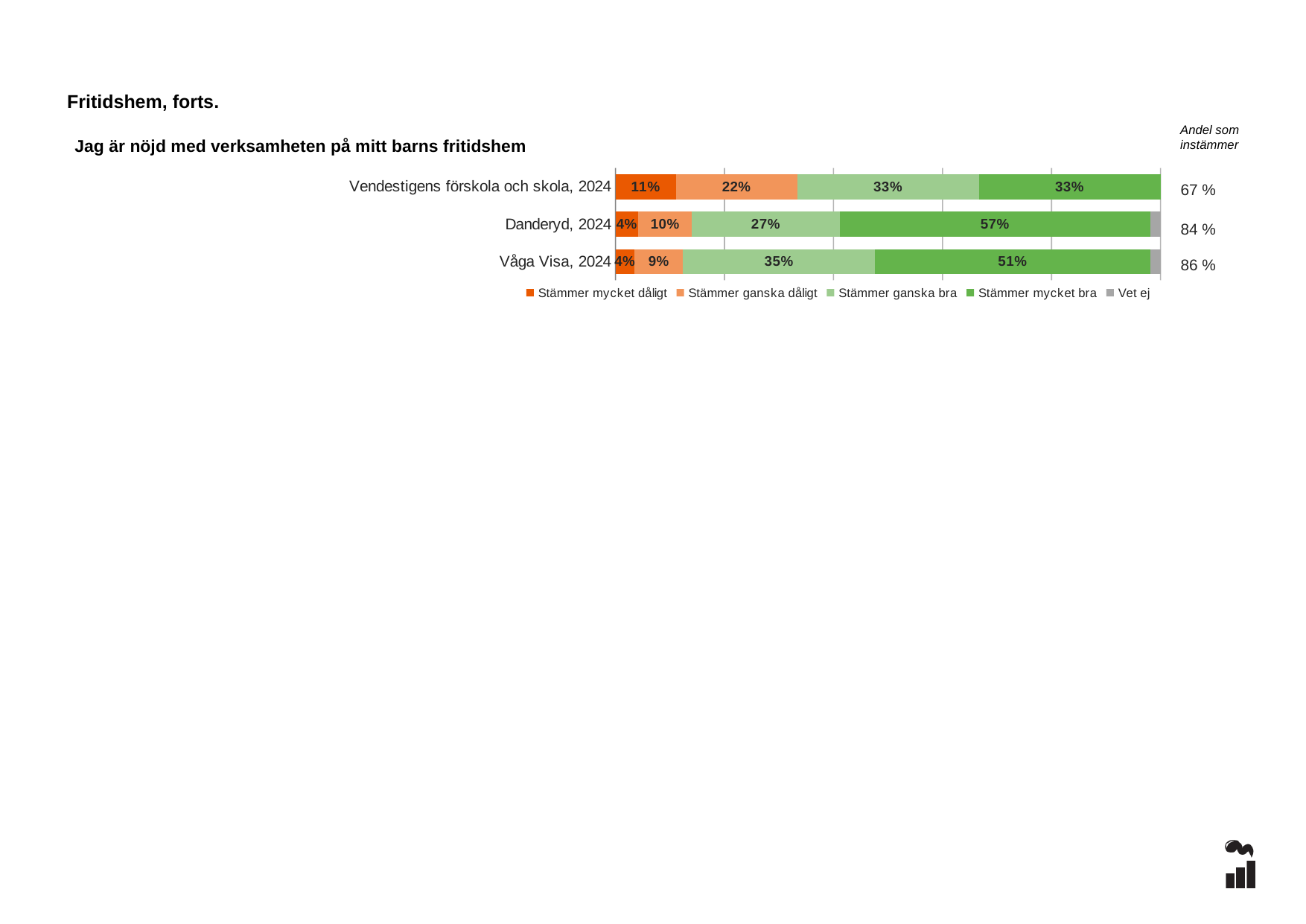
How many categories (bars) are shown in the chart? 3 What is the difference between the "Stämmer ganska dåligt" share for Vendestigens förskola och skola, 2024 and for Danderyd, 2024? 12% What kind of chart is shown on the slide? Stacked bar chart What percentage of respondents for Vendestigens förskola och skola, 2024 answered "Stämmer mycket dåligt"? 11% How many series does the legend list? 5 Which category has the lowest share of "Stämmer mycket bra" responses? Vendestigens förskola och skola, 2024 What percentage of respondents for Vendestigens förskola och skola, 2024 answered "Stämmer mycket bra"? 33% Which category has the highest share of "Stämmer mycket bra" responses? Danderyd, 2024 Which is larger: the "Stämmer ganska bra" share for Våga Visa, 2024 or for Danderyd, 2024? Våga Visa, 2024 What percentage of respondents for Danderyd, 2024 answered "Stämmer mycket bra"? 57% What is the "Andel som instämmer" value shown for Våga Visa, 2024? 86 % What percentage of respondents for Våga Visa, 2024 answered "Stämmer ganska bra"? 35%